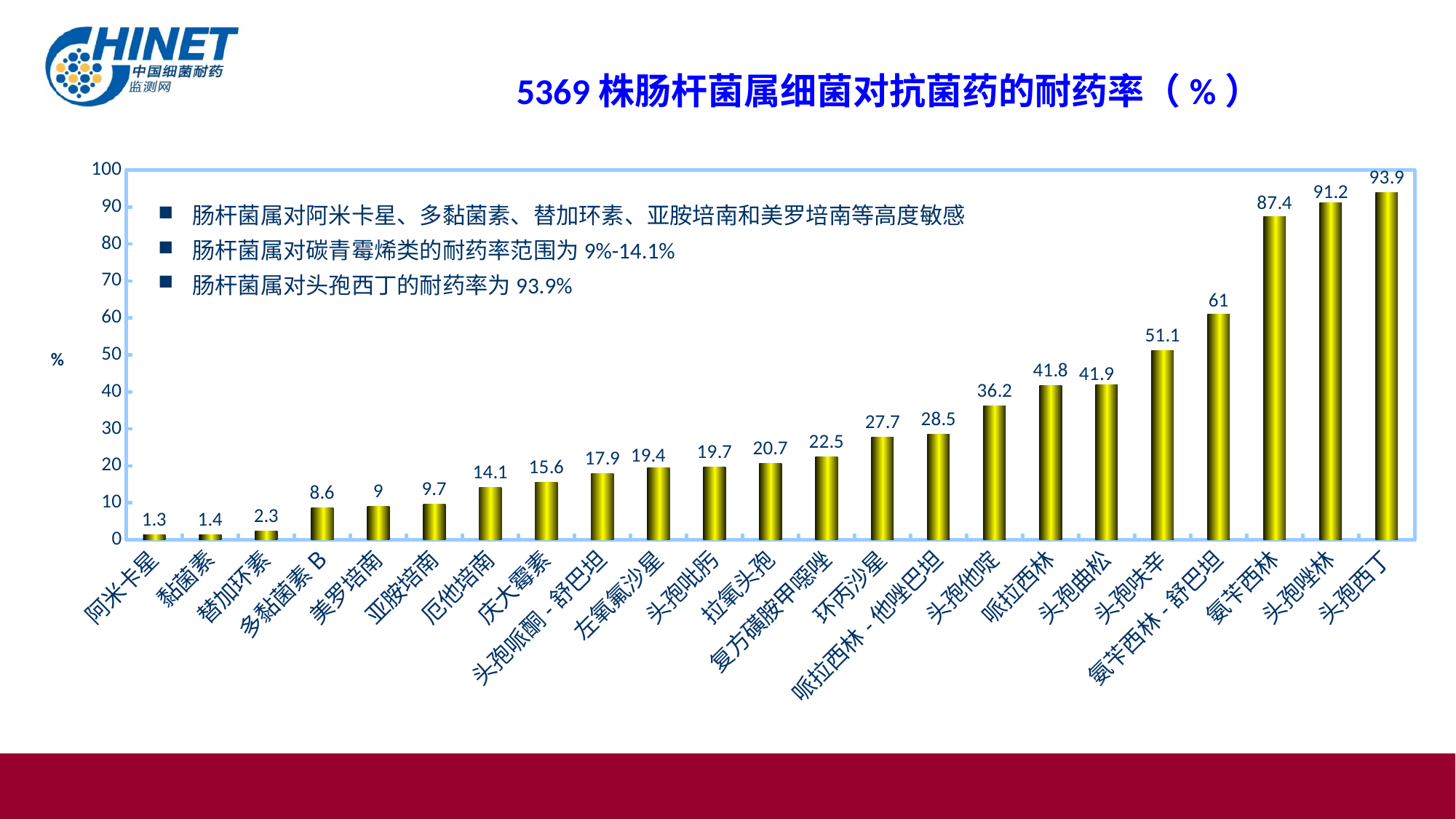
What is the resistance rate for 头孢呋辛? 51.1 Which antibiotic has the highest resistance rate? 头孢西丁 Do the values rise or fall from left to right along the x axis? rise What is the resistance rate for 厄他培南? 14.1 Is the value for 哌拉西林 greater or less than 40? greater Which has a higher resistance rate, 头孢唑林 or 氨苄西林? 头孢唑林 How many antibiotics are shown on the x axis? 23 What kind of chart is shown on the slide? bar chart What is the resistance rate for 头孢西丁? 93.9 What is the difference between the resistance rates for 氨苄西林 and 氨苄西林-舒巴坦? 26.4 What is the difference between the resistance rates for 头孢他啶 and 环丙沙星? 8.5 Which antibiotic has the lowest resistance rate? 阿米卡星